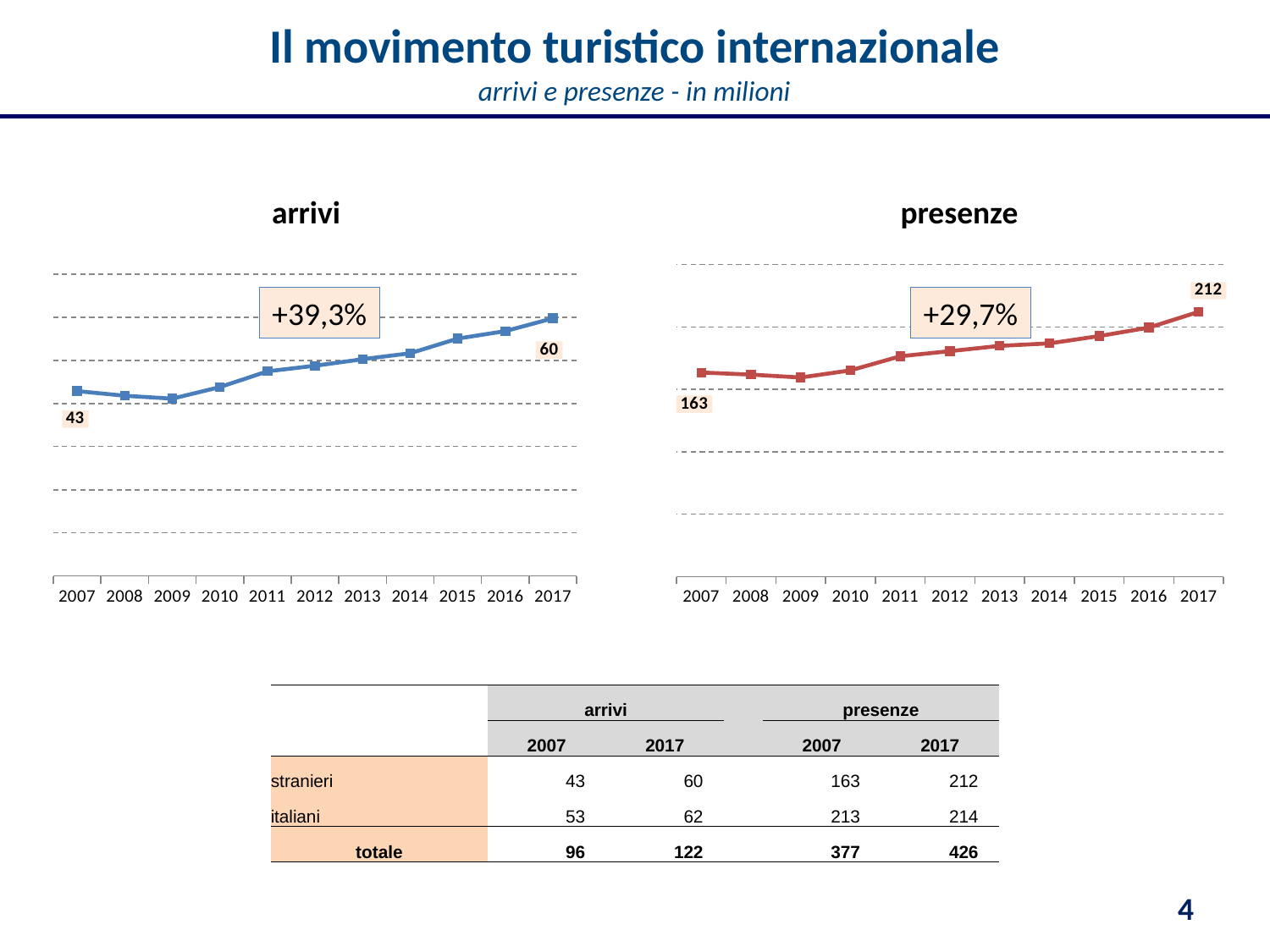
In the 'presenze' chart, which year has the highest value? 2017 In the 'arrivi' chart, what is the value for 2017? 60 In the 'presenze' chart, what is the difference between the 2017 and 2007 values? 49 What percentage change is shown in the box on the 'arrivi' chart? +39,3% In the 'presenze' chart, what is the value for 2007? 163 In the 'presenze' chart, what is the value for 2017? 212 How many years are plotted on the x axis of the 'arrivi' chart? 11 In the 'arrivi' chart, what is the difference between the 2017 and 2007 values? 17 In the 'arrivi' chart, which year has the highest value? 2017 What kind of chart is the 'presenze' chart? line chart In the 'arrivi' chart, what is the value for 2007? 43 In the 'presenze' chart, do the values generally rise or fall from 2007 to 2017? rise